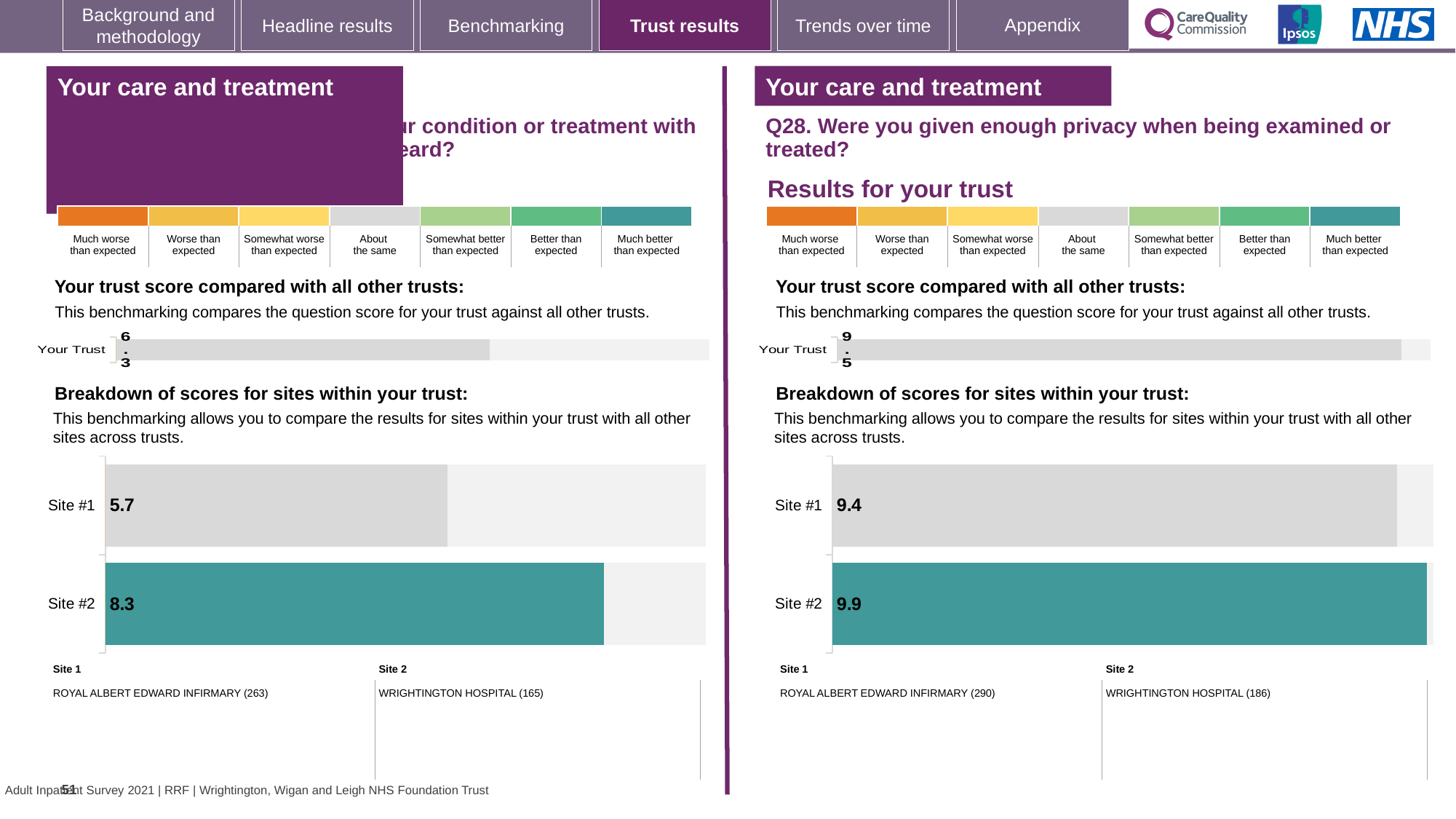
What type of chart is the Q28 'Breakdown of scores for sites within your trust' chart? Bar chart On the left-hand 'Breakdown of scores for sites within your trust' chart, what is the score for Site #2? 8.3 On the Q28 site breakdown chart, which site has the lower score? Site #1 On the left-hand 'Your trust score compared with all other trusts' chart, what is the score for Your Trust? 6.3 On the left-hand site breakdown chart, what is the difference between the Site #2 and Site #1 scores? 2.6 On the Q28 'Your trust score compared with all other trusts' chart, what is the score for Your Trust? 9.5 On the Q28 'Breakdown of scores for sites within your trust' chart, what is the score for Site #1? 9.4 On the Q28 site breakdown chart, what is the difference between the Site #2 and Site #1 scores? 0.5 How many sites are shown on the Q28 site breakdown chart? 2 On the left-hand site breakdown chart, which site has the higher score? Site #2 On the left-hand 'Breakdown of scores for sites within your trust' chart, what is the score for Site #1? 5.7 On the Q28 'Breakdown of scores for sites within your trust' chart, what is the score for Site #2? 9.9